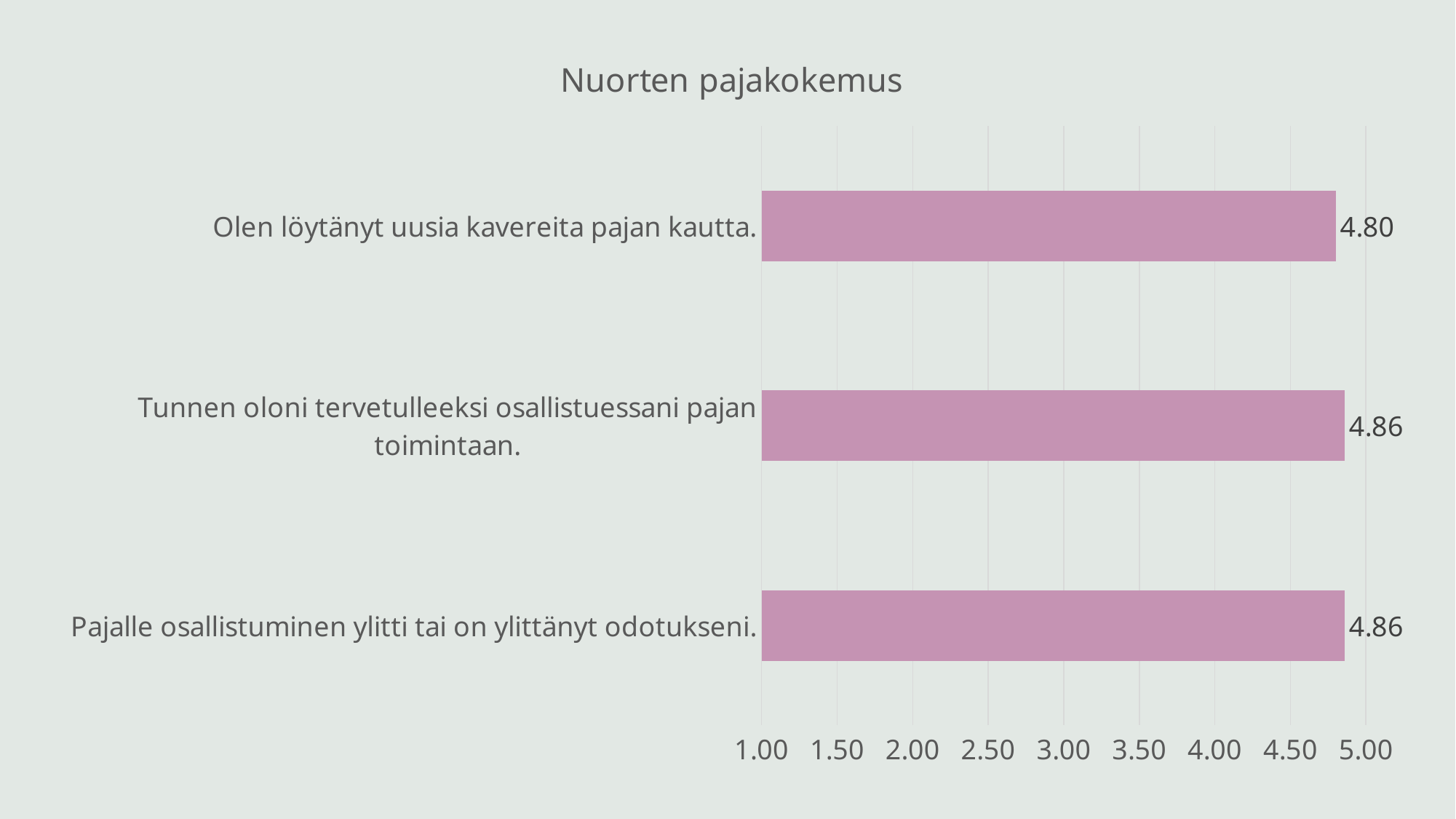
What is the highest value shown on the horizontal axis? 5.00 Which is larger: the value for "Pajalle osallistuminen ylitti tai on ylittänyt odotukseni." or the value for "Olen löytänyt uusia kavereita pajan kautta."? Pajalle osallistuminen ylitti tai on ylittänyt odotukseni. Is the value for "Olen löytänyt uusia kavereita pajan kautta." greater or less than 4.50? greater Is the value for "Tunnen oloni tervetulleeksi osallistuessani pajan toimintaan." greater or less than 5.00? less What is the value for "Pajalle osallistuminen ylitti tai on ylittänyt odotukseni."? 4.86 What kind of chart is shown on the slide? bar chart What is the difference between the values for "Tunnen oloni tervetulleeksi osallistuessani pajan toimintaan." and "Olen löytänyt uusia kavereita pajan kautta."? 0.06 How many categories are shown in the chart? 3 Which category has the lowest value? Olen löytänyt uusia kavereita pajan kautta. What is the title of the chart? Nuorten pajakokemus What is the value for "Tunnen oloni tervetulleeksi osallistuessani pajan toimintaan."? 4.86 What is the value for "Olen löytänyt uusia kavereita pajan kautta."? 4.80